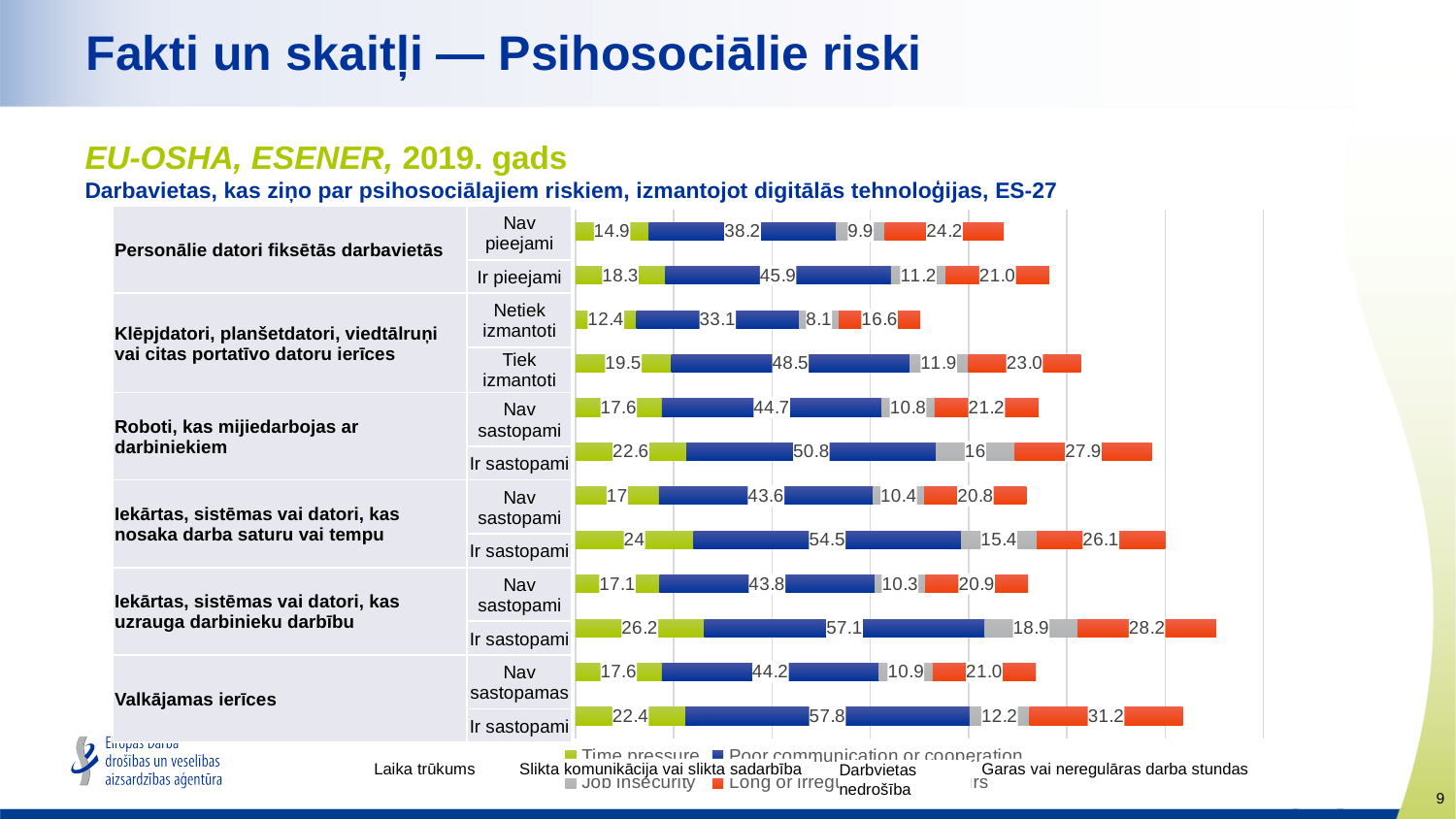
What is the total of the stacked bar for 'Klēpjdatori, planšetdatori, viedtālruņi vai citas portatīvo datoru ierīces – Netiek izmantoti'? 70.2 What is the Job insecurity value for 'Roboti, kas mijiedarbojas ar darbiniekiem – Ir sastopami'? 16 How many stacked bars (category rows) does the chart show? 12 What kind of chart is shown on the slide? bar chart What is the Time pressure value for 'Personālie datori fiksētās darbavietās – Ir pieejami'? 18.3 What is the Poor communication or cooperation value for 'Valkājamas ierīces – Ir sastopami'? 57.8 How many series does the chart legend list? 4 Which category row has the highest Time pressure value? Iekārtas, sistēmas vai datori, kas uzrauga darbinieku darbību – Ir sastopami What is the difference between the Long or irregular working hours values for 'Valkājamas ierīces – Ir sastopami' and 'Valkājamas ierīces – Nav sastopamas'? 10.2 What is the Long or irregular working hours value for 'Klēpjdatori, planšetdatori, viedtālruņi vai citas portatīvo datoru ierīces – Netiek izmantoti'? 16.6 Which category row has the lowest Poor communication or cooperation value? Klēpjdatori, planšetdatori, viedtālruņi vai citas portatīvo datoru ierīces – Netiek izmantoti Which is larger: the Job insecurity value for 'Iekārtas, sistēmas vai datori, kas uzrauga darbinieku darbību – Ir sastopami' or for 'Iekārtas, sistēmas vai datori, kas nosaka darba saturu vai tempu – Ir sastopami'? Iekārtas, sistēmas vai datori, kas uzrauga darbinieku darbību – Ir sastopami